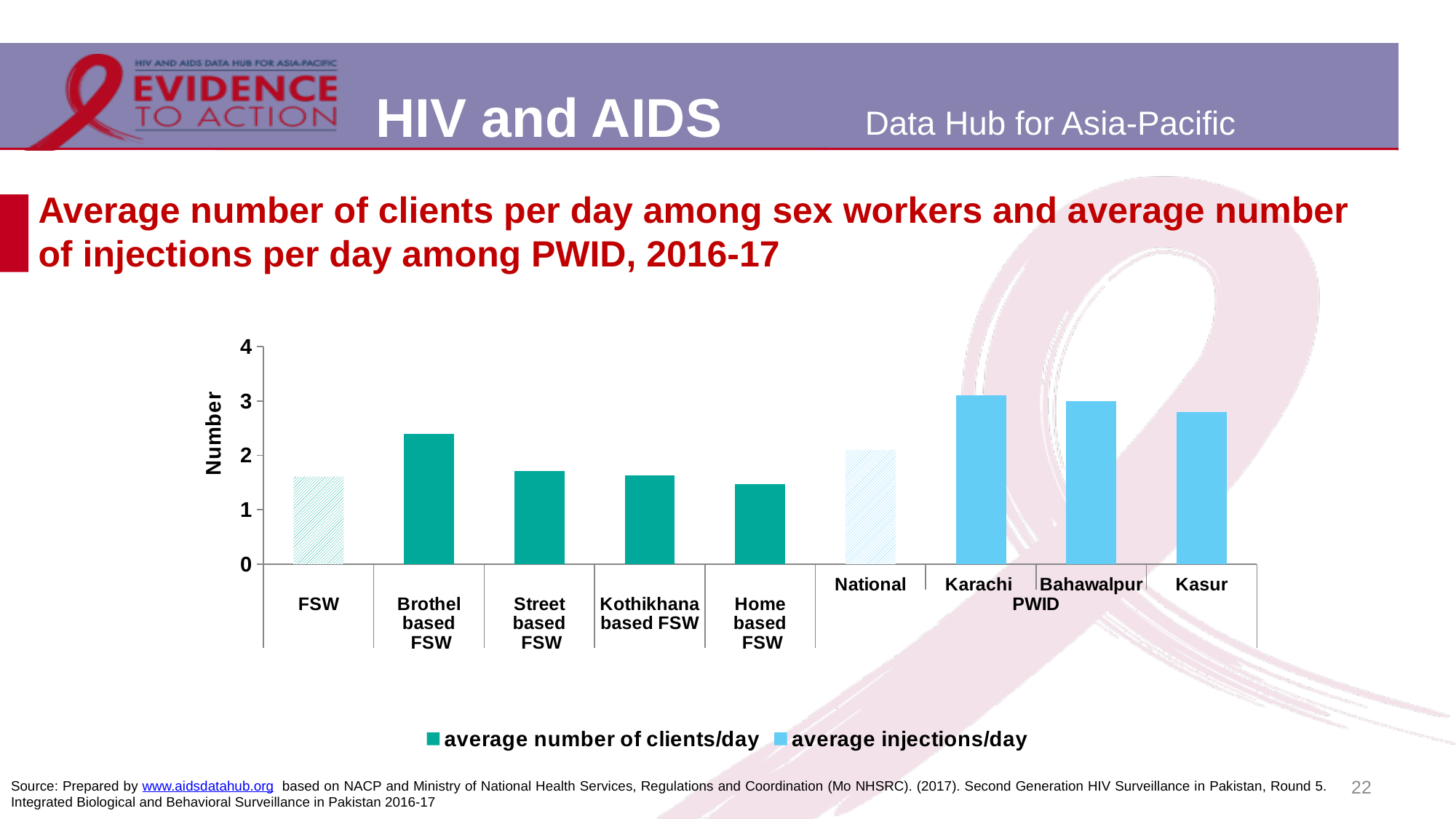
How many categories are plotted along the x axis? 9 How many series does the legend list? 2 Is the value for Brothel based FSW greater or less than 2? greater Is the value for Kasur greater or less than 3? less Among the FSW categories, which has the highest average number of clients per day? Brothel based FSW What is the title of the y axis? Number Which is larger, the value for Karachi or for Kasur? Karachi Which is larger, the value for Brothel based FSW or for Street based FSW? Brothel based FSW Is the value for FSW greater or less than 2? less What kind of chart is shown on the slide? bar chart Which category has the lowest value in the chart? Home based FSW